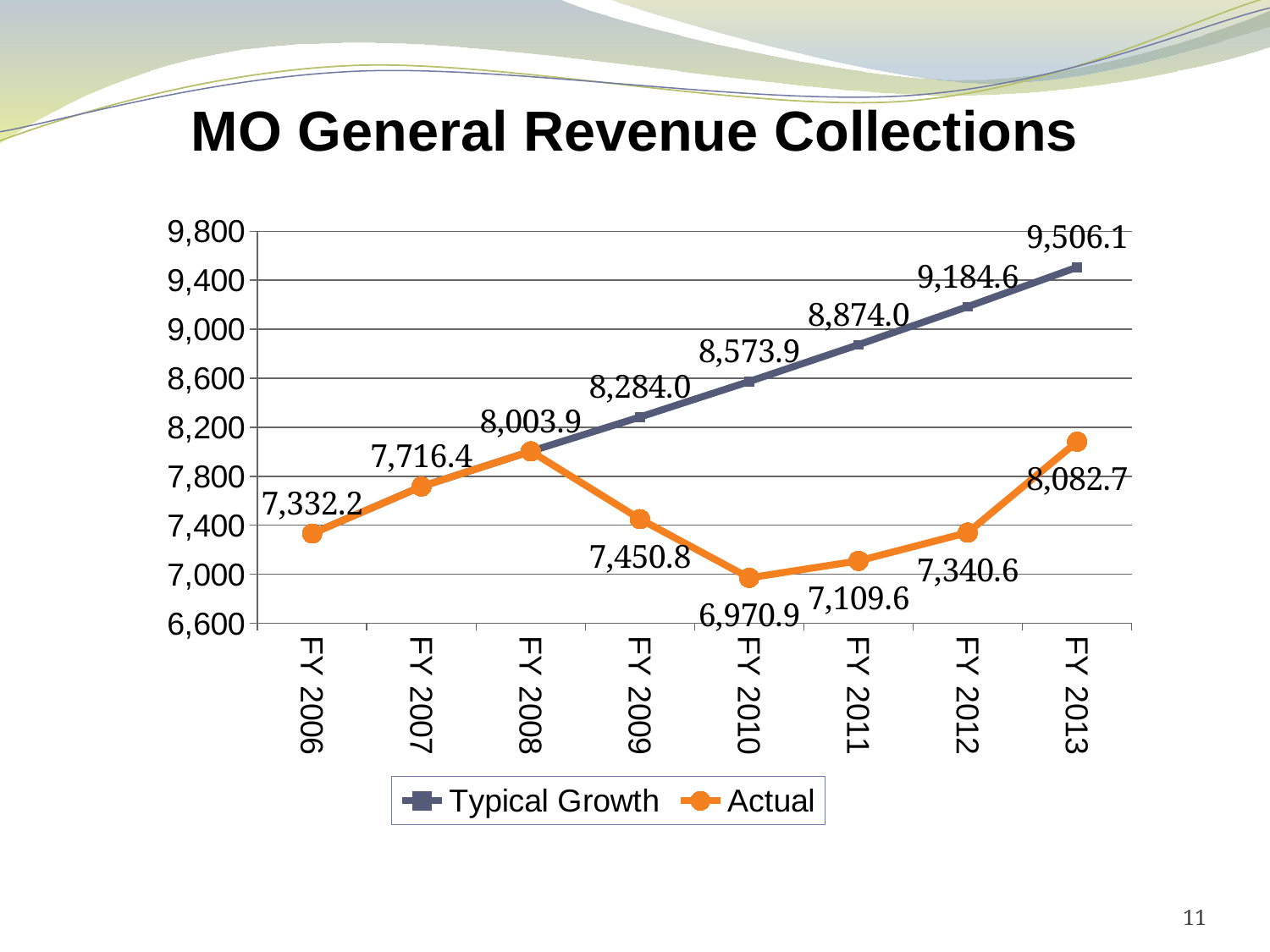
What is the Actual value for FY 2006? 7,332.2 Does the Typical Growth series rise or fall from FY 2009 to FY 2013? Rise How many fiscal years are shown on the x axis? 8 What is the Actual value for FY 2010? 6,970.9 Is the Actual value for FY 2012 greater or less than 7,400? less In which fiscal year is the Actual series at its highest? FY 2013 Which is larger for FY 2011: the Typical Growth value or the Actual value? Typical Growth What kind of chart is shown on the slide? Line chart What is the difference between the Typical Growth value and the Actual value for FY 2013? 1,423.4 In which fiscal year is the Actual series at its lowest? FY 2010 How many series does the legend list? 2 What is the Typical Growth value for FY 2013? 9,506.1